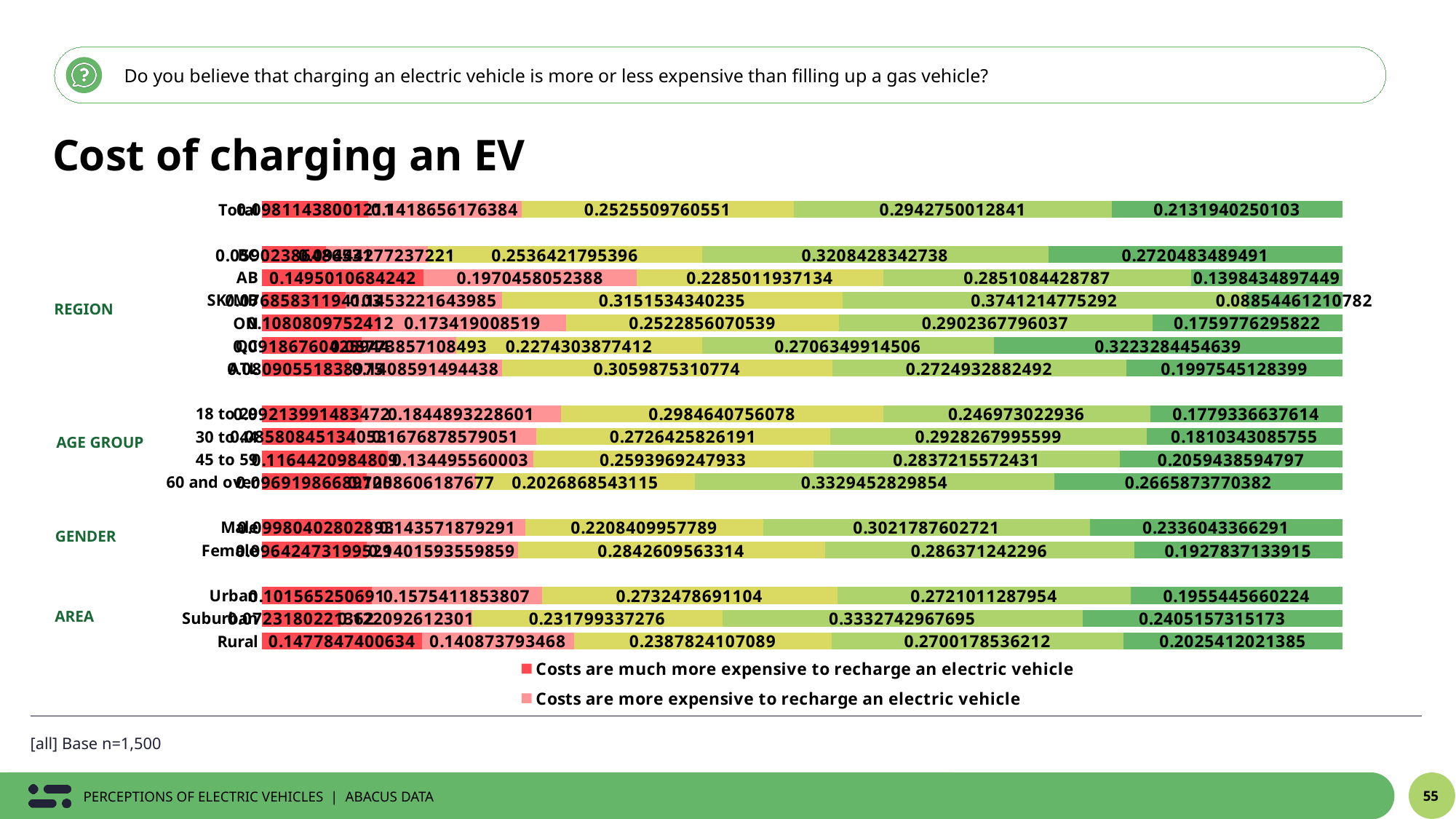
What is the value of the light green segment for Suburban? 0.3332742967695 What is the value of the dark green segment for Male? 0.2336043366291 What is the value for AB in the 'Costs are much more expensive to recharge an electric vehicle' series? 0.1495010684242 What is the value for Rural in the 'Costs are more expensive to recharge an electric vehicle' series? 0.140873793468 Which has the larger value in the 'Costs are much more expensive to recharge an electric vehicle' series, AB or ON? AB Which has the larger dark green segment value, Male or Female? Male What is the difference between the light green and dark green segment values for Male? 0.068574423643 How many age group categories are shown in the chart? 4 Which has the larger yellow segment value, 18 to 29 or 45 to 59? 18 to 29 What kind of chart is shown on the slide? Stacked bar chart What is the value of the light green segment for 60 and over? 0.3329452829854 What is the value of the dark green segment for Total? 0.2131940250103